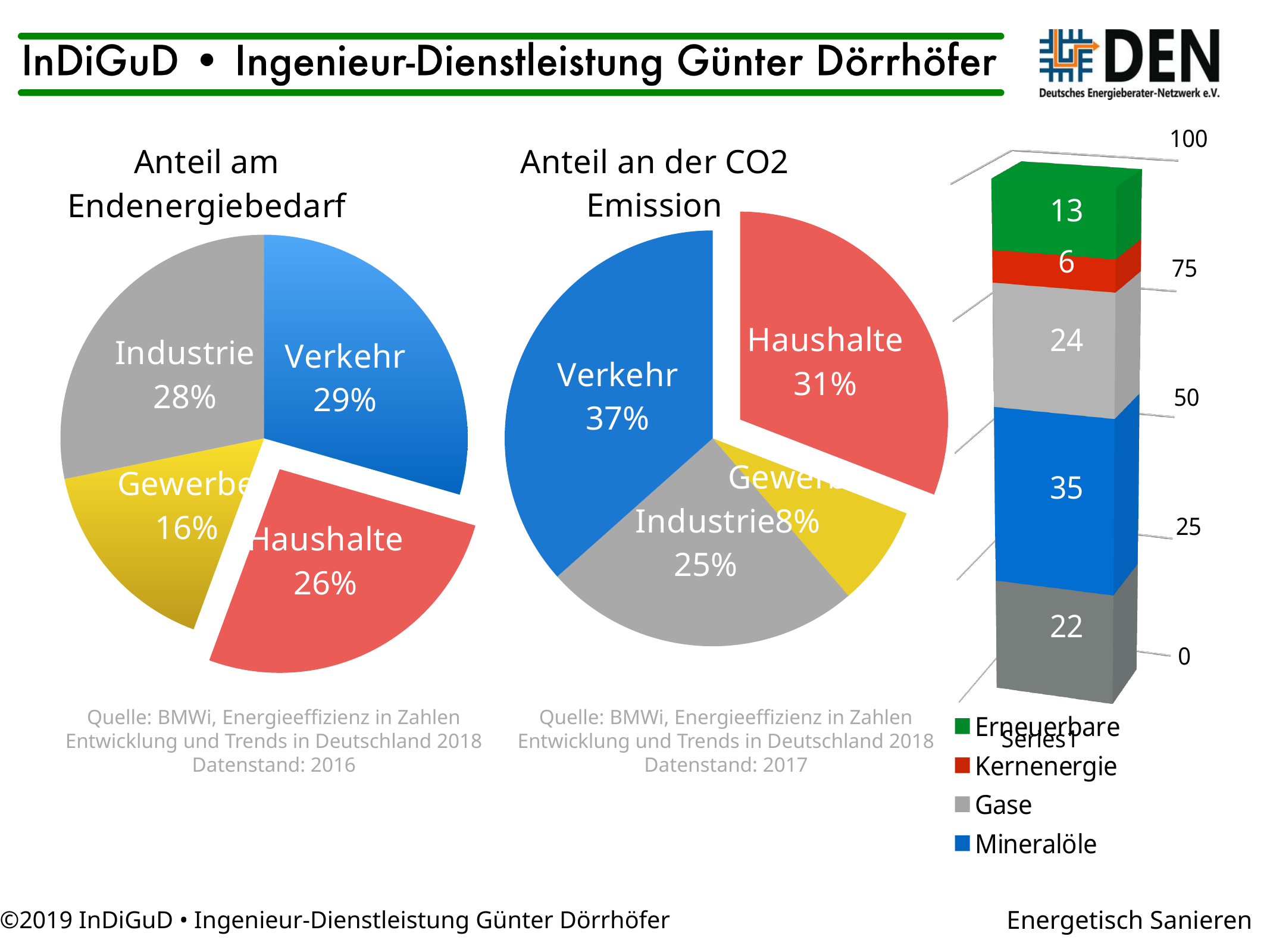
In the 'Anteil am Endenergiebedarf' pie chart, what share does Verkehr have? 29% Which is larger: the Haushalte share in the 'Anteil am Endenergiebedarf' pie chart or the Haushalte share in the 'Anteil an der CO2 Emission' pie chart? Anteil an der CO2 Emission In the stacked bar chart on the right, what is the value of the Kernenergie segment? 6 In the stacked bar chart on the right, what is the total of all segments in the bar? 100 In the 'Anteil am Endenergiebedarf' pie chart, which category has the smallest share? Gewerbe In the 'Anteil an der CO2 Emission' pie chart, what is the difference between the Verkehr share and the Industrie share? 12% In the 'Anteil am Endenergiebedarf' pie chart, what share does Gewerbe have? 16% In the 'Anteil an der CO2 Emission' pie chart, which category has the largest share? Verkehr How many slices does the 'Anteil am Endenergiebedarf' pie chart have? 4 In the 'Anteil an der CO2 Emission' pie chart, what share does Haushalte have? 31% In the stacked bar chart on the right, what is the value of the Mineralöle segment? 35 What kind of chart is the chart on the right of the slide? Stacked bar chart